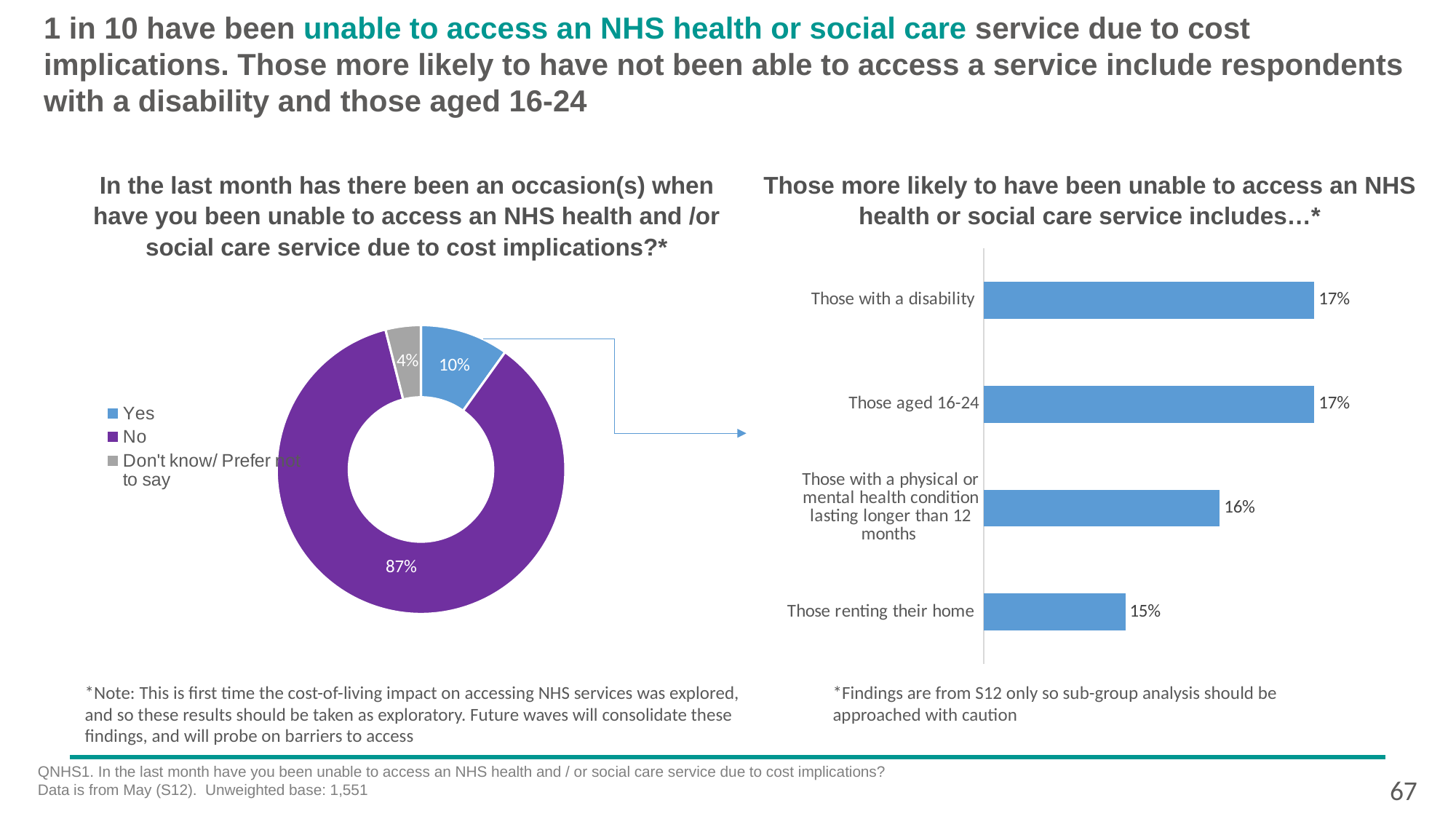
In the left-hand donut chart, which response has the largest share? No In the left-hand donut chart, what percentage of respondents answered 'No'? 87% In the left-hand donut chart, what percentage answered 'Don't know/ Prefer not to say'? 4% In the left-hand donut chart, which response has the smallest share? Don't know/ Prefer not to say What type of chart is shown on the right-hand side of the slide? Bar chart In the right-hand bar chart, what is the value for 'Those renting their home'? 15% In the right-hand bar chart, what is the difference between the value for 'Those with a disability' and the value for 'Those renting their home'? 2% In the left-hand donut chart, what percentage of respondents answered 'Yes'? 10% In the right-hand bar chart, which is larger: the value for 'Those aged 16-24' or the value for 'Those renting their home'? Those aged 16-24 How many entries does the legend of the left-hand donut chart list? 3 How many categories are shown in the right-hand bar chart? 4 In the right-hand bar chart, what is the value for 'Those with a physical or mental health condition lasting longer than 12 months'? 16%